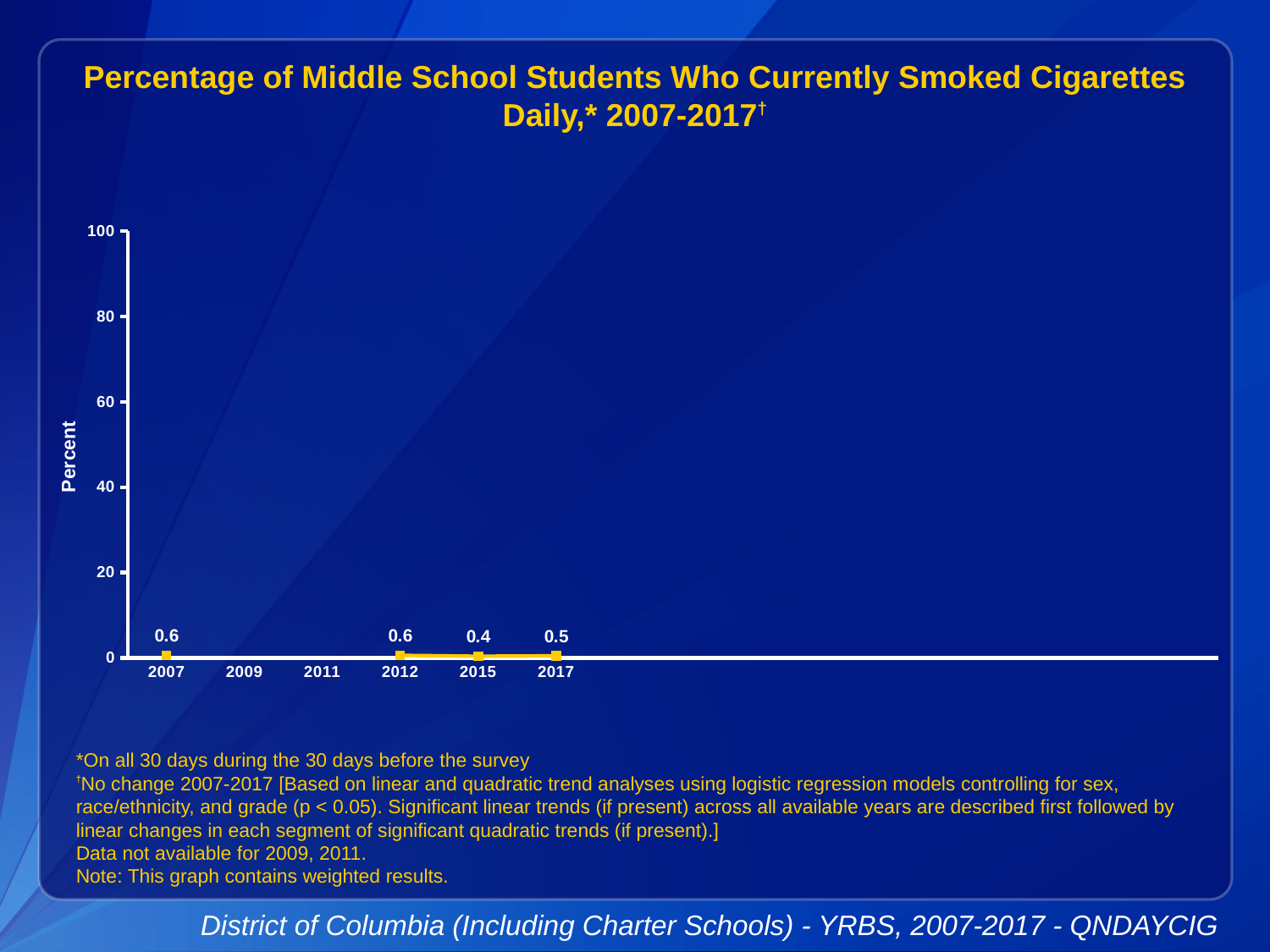
What is the value for 2007? 0.6 For which years is data not available? 2009, 2011 Which year has the lowest value? 2015 What is the label on the y axis? Percent What kind of chart is this? line chart How many years are labeled on the x axis? 6 Is the value for 2007 greater or less than 20? less What is the value for 2017? 0.5 What is the difference between the values for 2012 and 2015? 0.2 Which is larger, the value for 2015 or the value for 2017? 2017 What is the value for 2015? 0.4 What is the value for 2012? 0.6